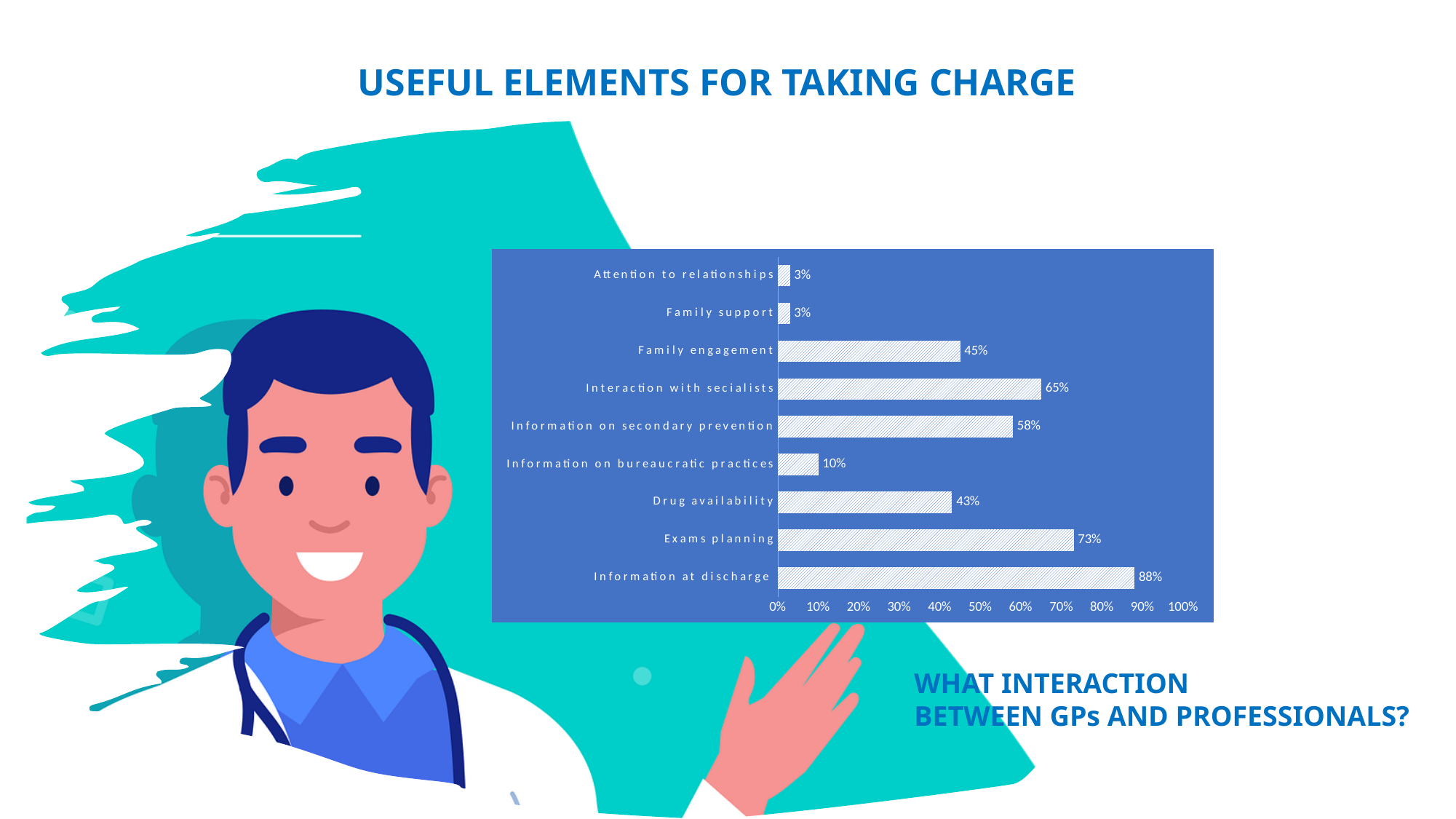
What is the title of the slide above the chart? USEFUL ELEMENTS FOR TAKING CHARGE Which category has the highest value? Information at discharge What is the value for Drug availability? 43% Is the value for Family engagement greater or less than 50%? less What is the value for Information on bureaucratic practices? 10% What is the difference between Information at discharge and Exams planning? 15% How many categories are shown in the chart? 9 Which is larger, Interaction with secialists or Information on secondary prevention? Interaction with secialists What is the value for Exams planning? 73% What is the difference between Family engagement and Drug availability? 2% What is the value for Information at discharge? 88% What kind of chart is shown on the slide? bar chart